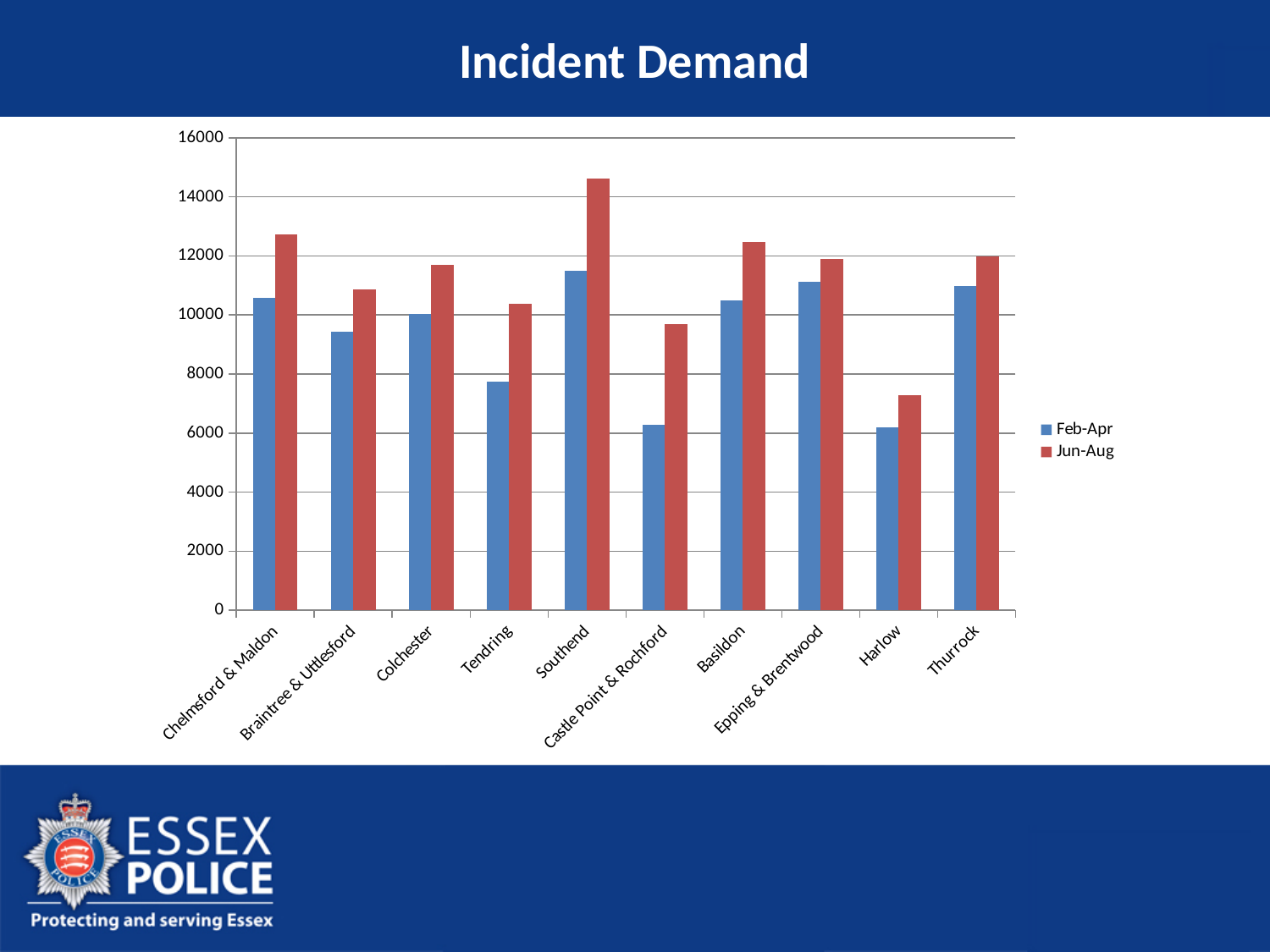
For Basildon, which is larger: the Feb-Apr value or the Jun-Aug value? Jun-Aug Is the Jun-Aug value for Chelmsford & Maldon greater or less than 12000? greater Is the Feb-Apr value for Tendring greater or less than 8000? less What kind of chart is shown on the slide? bar chart Is the Feb-Apr value for Harlow greater or less than 8000? less How many series does the legend list? 2 How many categories are shown on the x axis? 10 What is the title of the chart? Incident Demand Which category has the highest Jun-Aug value? Southend Which category has the highest Feb-Apr value? Southend Which category has the lowest Jun-Aug value? Harlow